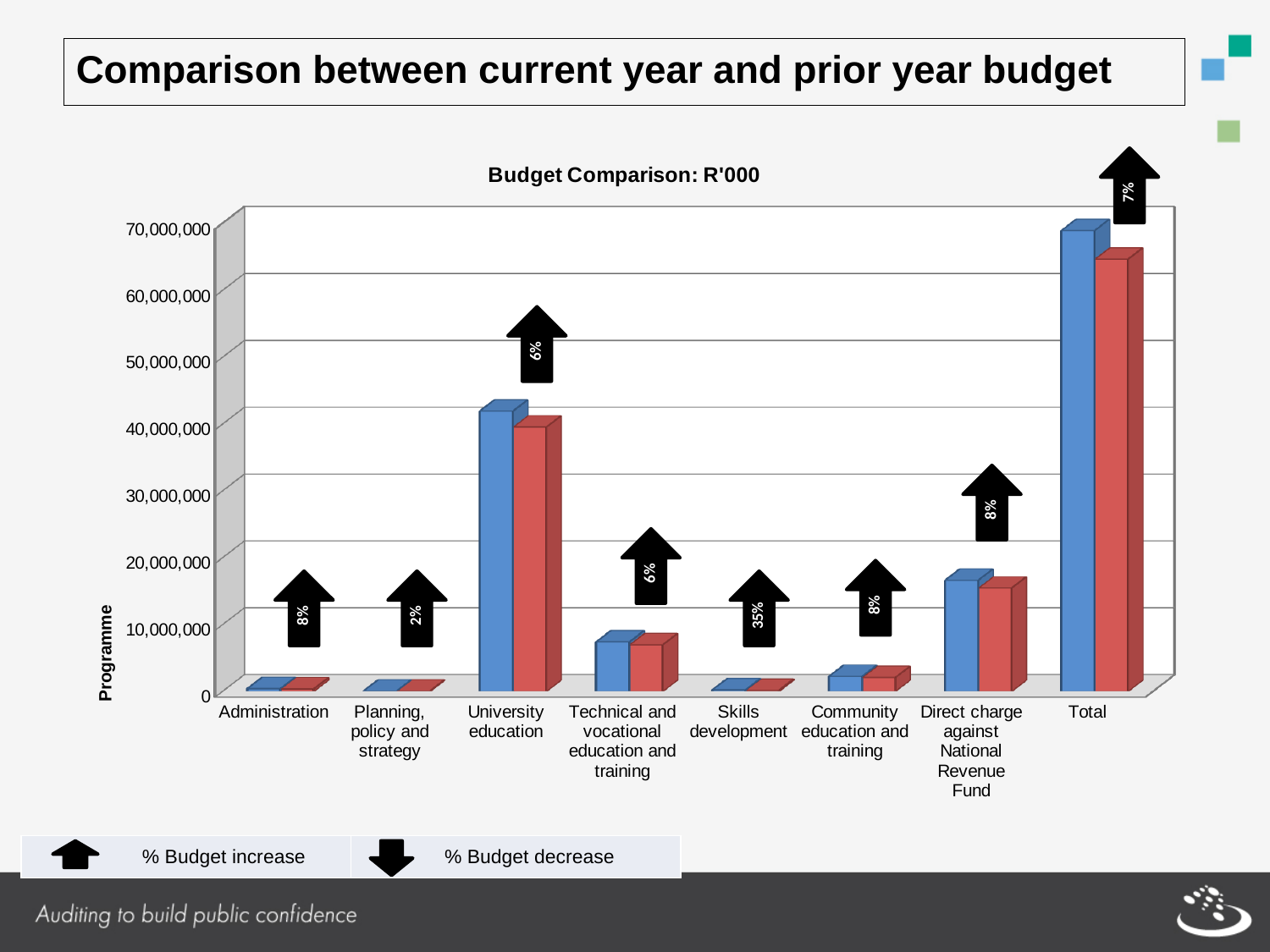
What percentage budget increase is shown above Total? 7% What percentage budget increase is shown above Planning, policy and strategy? 2% Is the value of the blue bar for Direct charge against National Revenue Fund greater or less than 20,000,000? less Which is larger for Technical and vocational education and training: the blue bar or the bar for Community education and training (blue)? Technical and vocational education and training Excluding Total, which category has the tallest bars? University education What kind of chart is shown on the slide? bar chart What percentage budget increase is shown above Skills development? 35% Is the value of the blue bar for University education greater or less than 40,000,000? greater How many categories are shown along the x axis of the chart? 8 What is the title of the chart? Budget Comparison: R'000 Which category has the smallest percentage budget increase? Planning, policy and strategy Which category has the largest percentage budget increase? Skills development